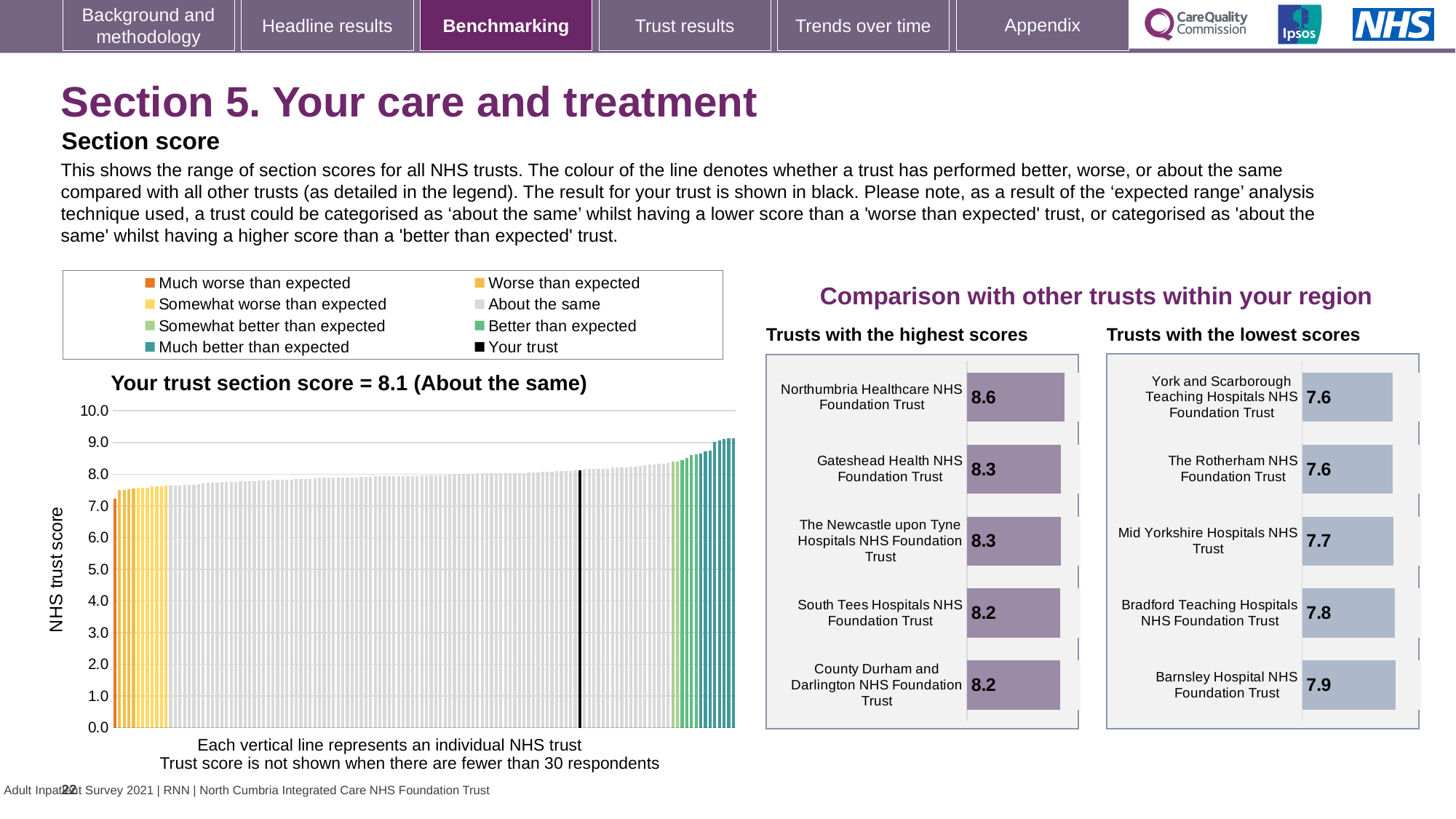
In the 'Trusts with the highest scores' chart, which trust has the highest score? Northumbria Healthcare NHS Foundation Trust In the 'Your trust section score' chart, is the value of the leftmost bar greater or less than 8.0? less In the 'Your trust section score' chart, do the trust scores rise or fall from left to right along the x axis? rise In the 'Your trust section score' chart, what kind of chart is shown? bar chart In the 'Your trust section score' chart, what is the label on the y axis? NHS trust score In the 'Trusts with the lowest scores' chart, how many trusts are shown? 5 How many entries does the legend above the 'Your trust section score' chart list? 8 In the 'Trusts with the lowest scores' chart, what is the score for Mid Yorkshire Hospitals NHS Trust? 7.7 In the 'Trusts with the highest scores' chart, what is the score for Northumbria Healthcare NHS Foundation Trust? 8.6 In the 'Your trust section score' chart, what is the section score for your trust? 8.1 In the 'Trusts with the lowest scores' chart, which has the larger score, Bradford Teaching Hospitals NHS Foundation Trust or Mid Yorkshire Hospitals NHS Trust? Bradford Teaching Hospitals NHS Foundation Trust In the 'Trusts with the highest scores' chart, what is the difference between the scores of Northumbria Healthcare NHS Foundation Trust and Gateshead Health NHS Foundation Trust? 0.3